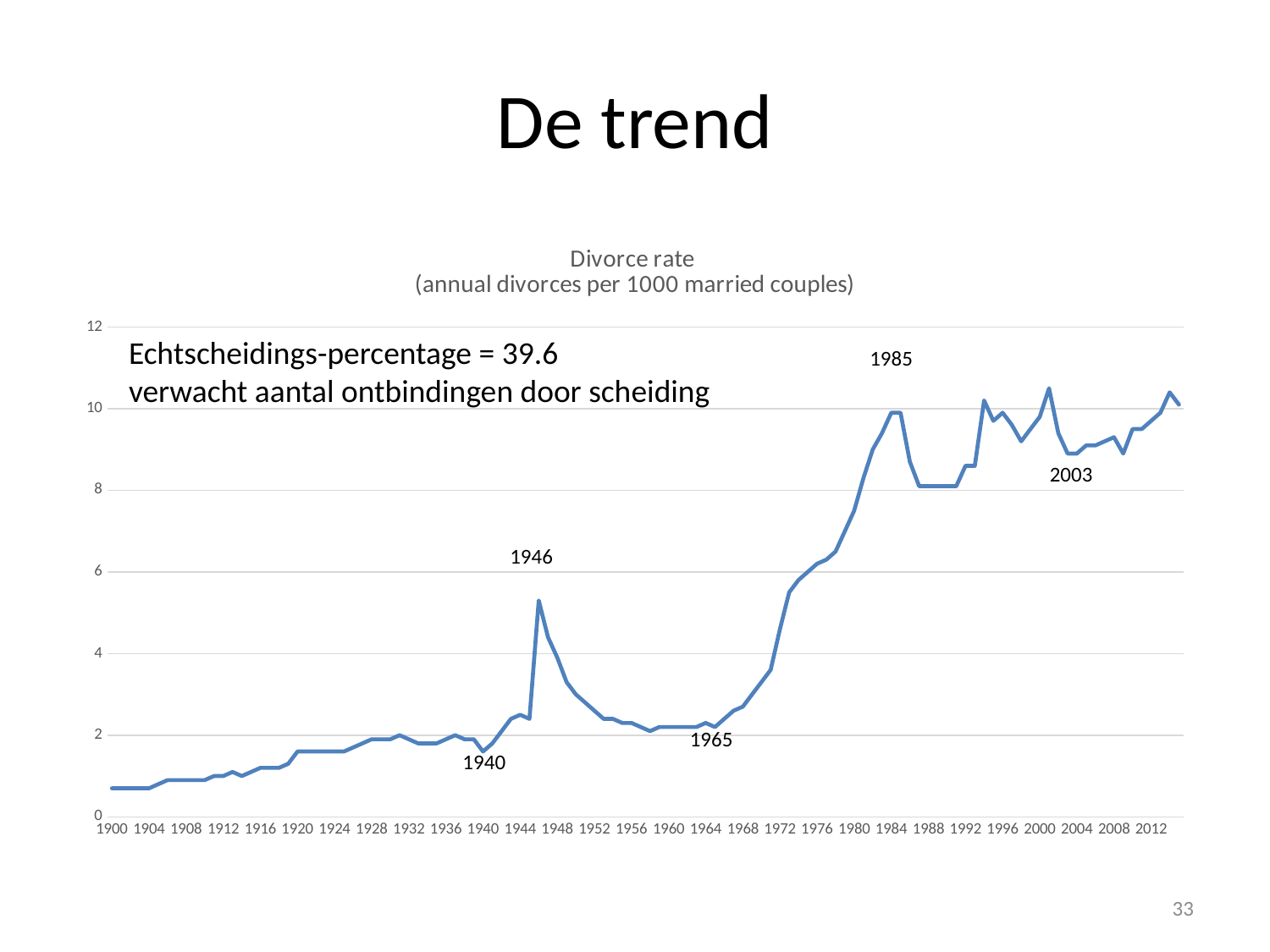
What is the highest value shown on the vertical axis? 12 Overall, does the divorce rate rise or fall from 1900 to 2012? rise Which year has the higher divorce rate, 1985 or 2003? 1985 What kind of chart is shown on the slide? line chart Is the divorce rate in 1985 greater or less than 8? greater Is the divorce rate at the 1946 peak greater or less than 4? greater Is the divorce rate at the 1946 peak greater or less than 6? less Which year has the higher divorce rate, 1946 or 1985? 1985 What is the title of the chart? Divorce rate (annual divorces per 1000 married couples)